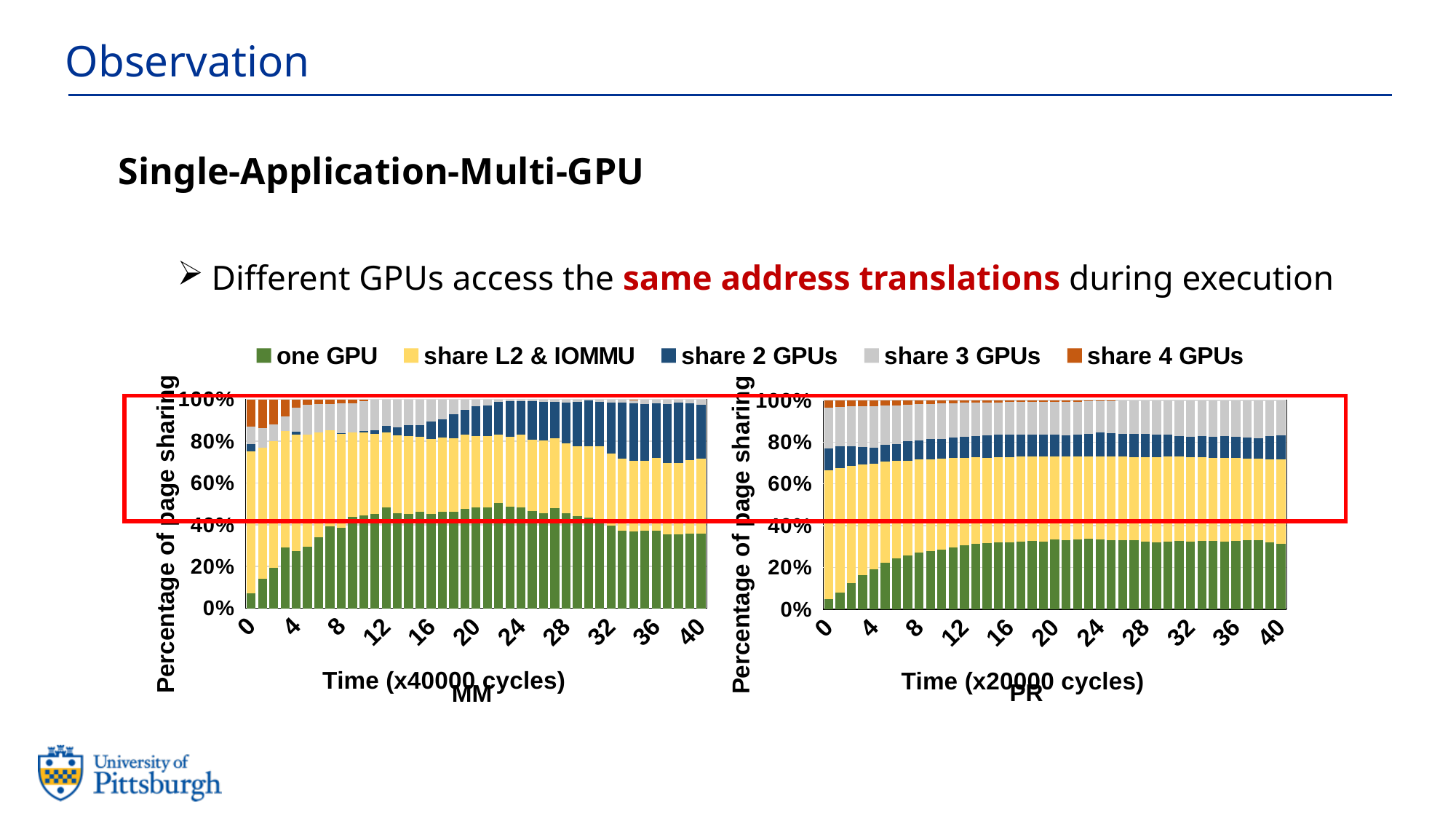
In the MM chart, is the 'one GPU' value at time 0 greater or less than 20%? less In the MM chart, is the 'one GPU' value at time 40 greater or less than 60%? less How many series does the legend list for the charts? 5 In the MM chart, does the 'one GPU' portion rise or fall between time 0 and time 8? rise In the PR chart, does the 'one GPU' portion rise or fall between time 0 and time 12? rise In the PR chart, is the 'one GPU' value at time 20 greater or less than 40%? less In the MM chart, what is the total height of each stacked bar? 100% What is the x-axis title of the MM chart? Time (x40000 cycles) How many labelled tick marks are on the x axis of the PR chart? 11 What kind of chart is the MM chart on the left? stacked bar chart What is the label of the y axis on the PR chart? Percentage of page sharing